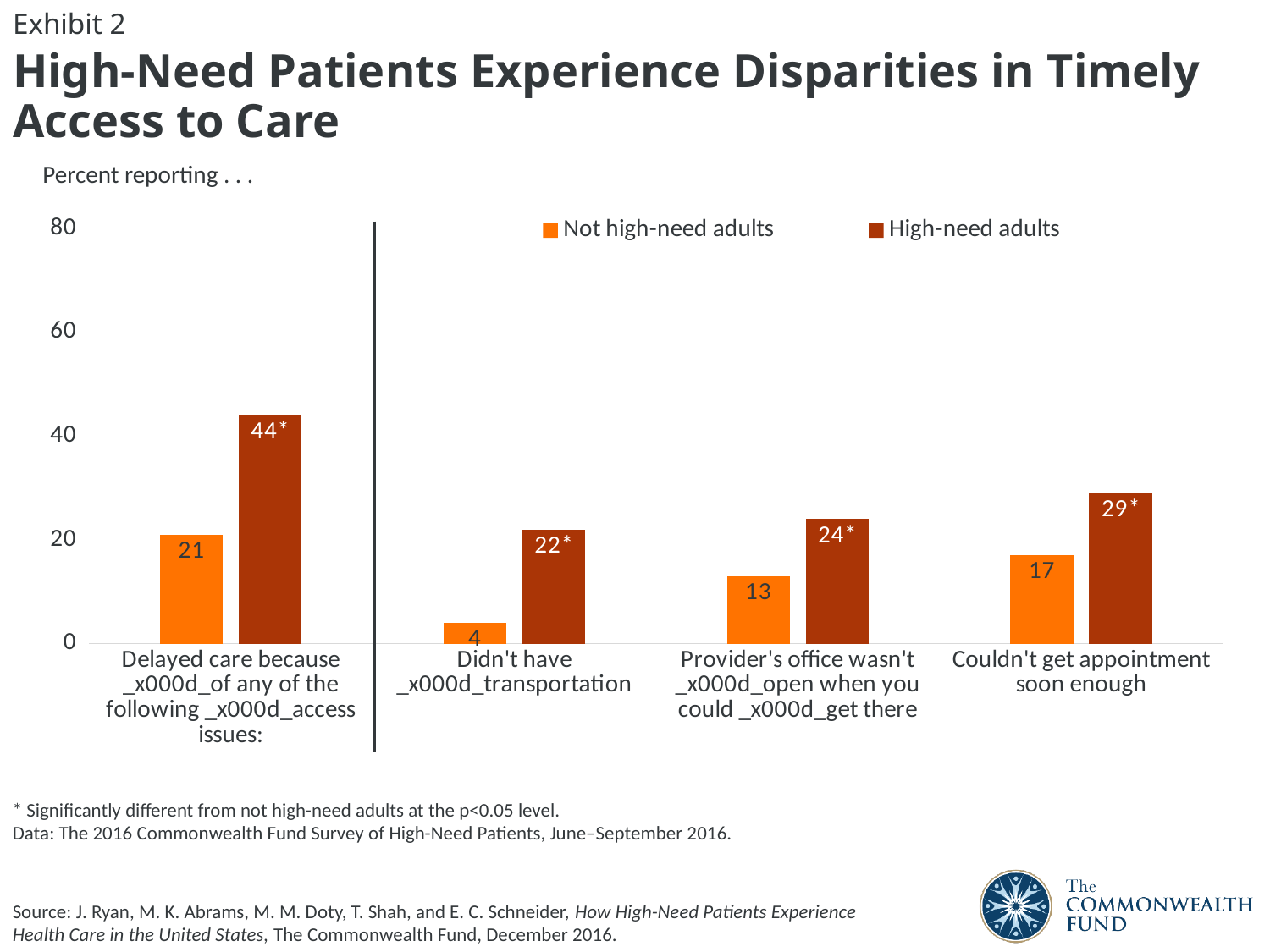
How many access issue categories are shown on the chart? 4 What percentage of high-need adults reported they couldn't get an appointment soon enough? 29 What is the difference between high-need adults and not high-need adults for delayed care because of any of the following access issues? 23 Which access issue has the highest value for high-need adults? Delayed care because of any of the following access issues What percentage of high-need adults reported delayed care because of any of the following access issues? 44 What percentage of not high-need adults reported they didn't have transportation? 4 For didn't have transportation, which group has the larger value: high-need adults or not high-need adults? High-need adults What percentage of not high-need adults reported the provider's office wasn't open when they could get there? 13 What kind of chart is shown on the slide? Bar chart What is the difference between high-need adults and not high-need adults for couldn't get appointment soon enough? 12 How many series does the legend list? 2 Which access issue has the lowest value for not high-need adults? Didn't have transportation